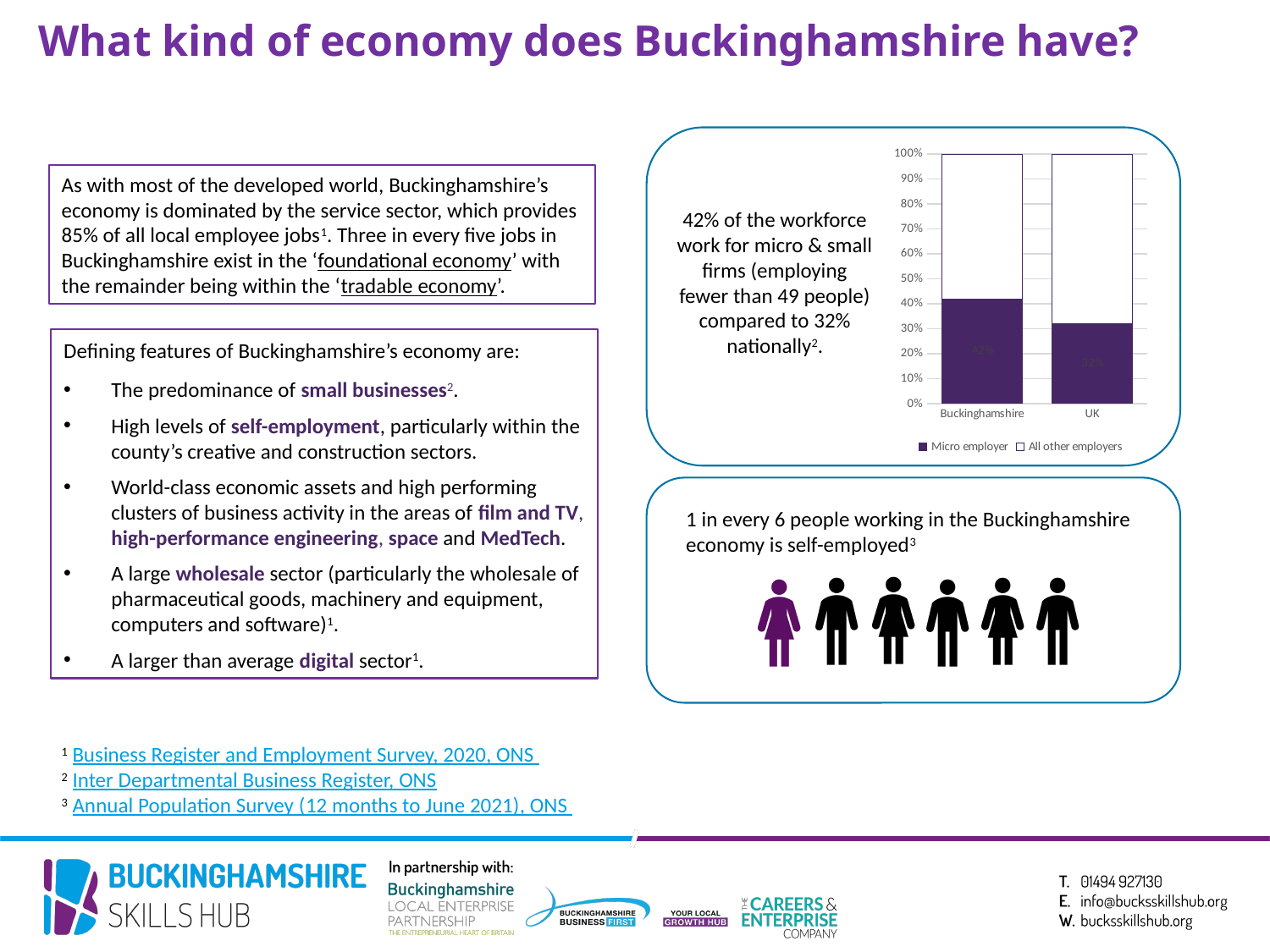
Which category has the higher Micro employer share, Buckinghamshire or UK? Buckinghamshire What is the Micro employer value for the UK? 32% What type of chart is shown on the slide? Stacked bar chart What is the Micro employer value for Buckinghamshire? 42% What is the difference between the Micro employer share for Buckinghamshire and for the UK? 10% What are the two series listed in the chart legend? Micro employer and All other employers How many categories are shown on the x axis of the chart? 2 Which category has the lowest Micro employer share? UK What is the highest value shown on the chart's y axis? 100% How many series does the chart legend list? 2 Is the Micro employer value for Buckinghamshire greater or less than 40%? greater Is the Micro employer value for the UK greater or less than 40%? less